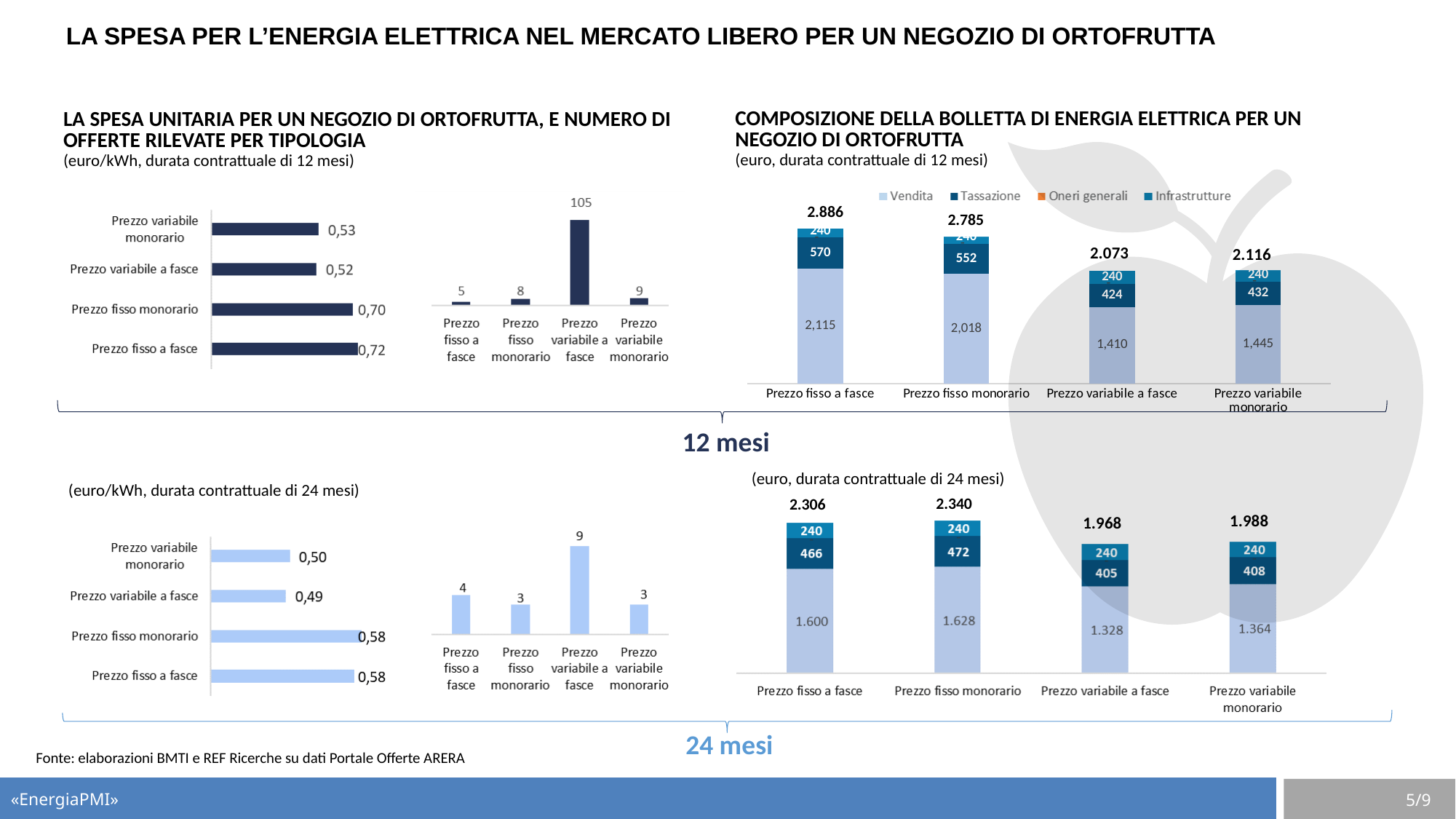
In the 24-month bill composition chart (euro, durata contrattuale di 24 mesi), which is larger: the total for Prezzo fisso monorario or the total for Prezzo variabile a fasce? Prezzo fisso monorario In the 12-month number-of-offers chart (top middle), how many offers are shown for Prezzo variabile a fasce? 105 In the 12-month unit price chart (euro/kWh, durata contrattuale di 12 mesi), which category has the lowest value? Prezzo variabile a fasce In the 12-month bill composition chart (euro, durata contrattuale di 12 mesi), what is the total for Prezzo fisso a fasce? 2.886 In the 24-month number-of-offers chart (bottom middle), how many offers are shown for Prezzo fisso a fasce? 4 How many series does the legend of the bill composition chart (COMPOSIZIONE DELLA BOLLETTA) list? 4 In the 24-month bill composition chart (euro, durata contrattuale di 24 mesi), what is the Tassazione value for Prezzo variabile monorario? 408 In the 12-month unit price chart (euro/kWh, durata contrattuale di 12 mesi), what is the value for Prezzo fisso a fasce? 0,72 In the 12-month number-of-offers chart (top middle), which category has the highest number of offers? Prezzo variabile a fasce In the 12-month bill composition chart (euro, durata contrattuale di 12 mesi), what is the Vendita value for Prezzo variabile a fasce? 1,410 In the 12-month number-of-offers chart (top middle), what is the difference between the offers for Prezzo variabile monorario and Prezzo fisso a fasce? 4 In the 24-month unit price chart (euro/kWh, durata contrattuale di 24 mesi), what is the value for Prezzo variabile monorario? 0,50